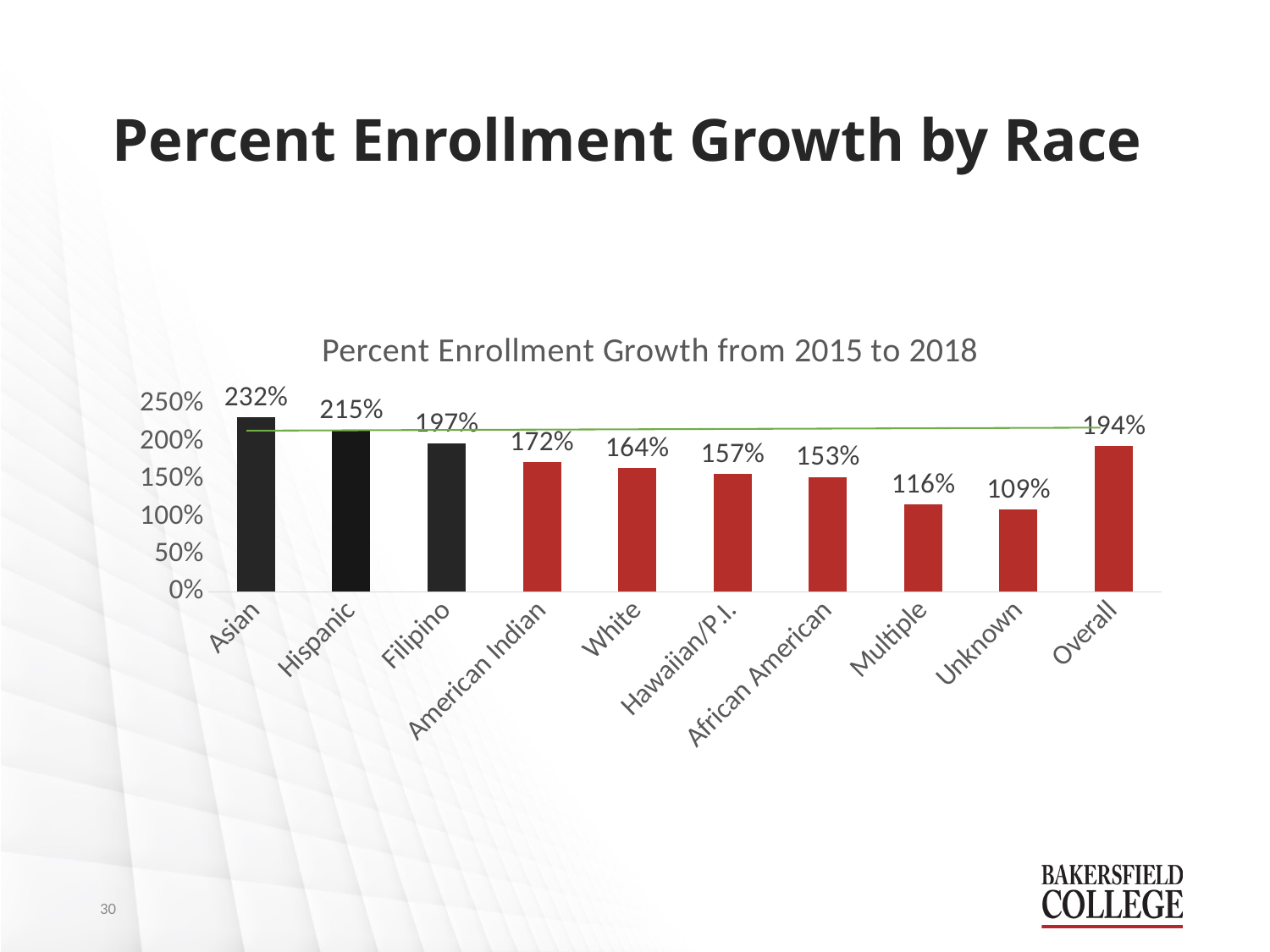
What is the percent enrollment growth for African American students? 153% Which has a higher percent enrollment growth, Filipino or American Indian? Filipino What is the title of the chart? Percent Enrollment Growth from 2015 to 2018 What is the percent enrollment growth for Asian students? 232% How many bars are coloured black rather than red? 3 How many categories are shown on the x axis of the chart? 10 Which category has the lowest percent enrollment growth? Unknown What kind of chart is shown on the slide? Bar chart What is the difference between the percent enrollment growth for Hispanic and White students? 51% What is the Overall percent enrollment growth shown on the chart? 194% Is the value for Multiple greater or less than 150%? less Which category has the highest percent enrollment growth? Asian